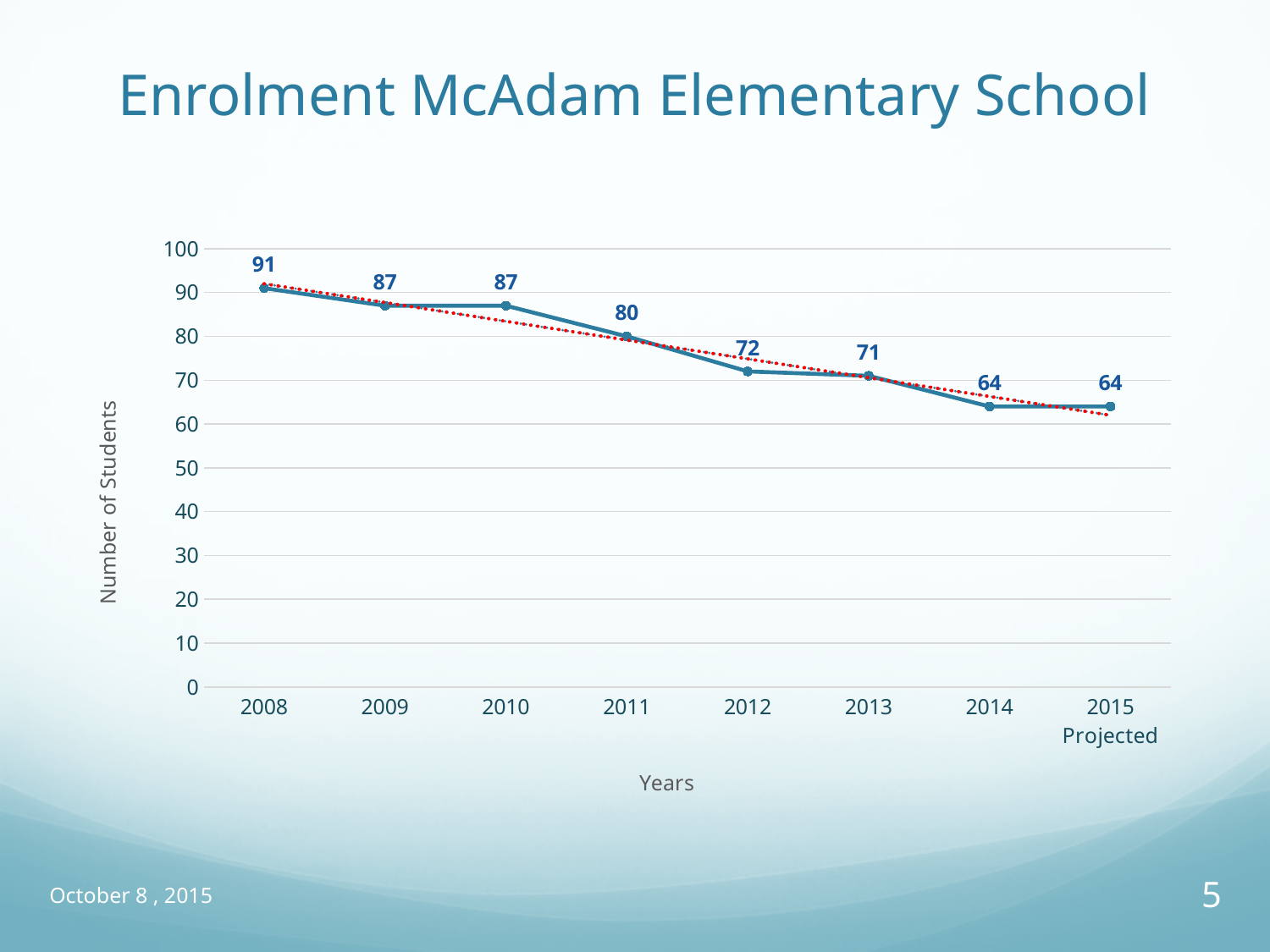
What is the label of the y axis? Number of Students What is the difference in enrolment between 2008 and 2014? 27 Is the enrolment value for 2012 greater or less than 80? less What kind of chart is shown on the slide? line chart Which year has the larger enrolment, 2010 or 2013? 2010 What is the projected enrolment for 2015? 64 What is the enrolment value for 2011? 80 What is the difference in enrolment between 2011 and 2012? 8 How many years are plotted on the x axis? 8 Do the enrolment values generally rise or fall from 2008 to 2015? fall What is the enrolment value for 2008? 91 Which year has the highest enrolment? 2008